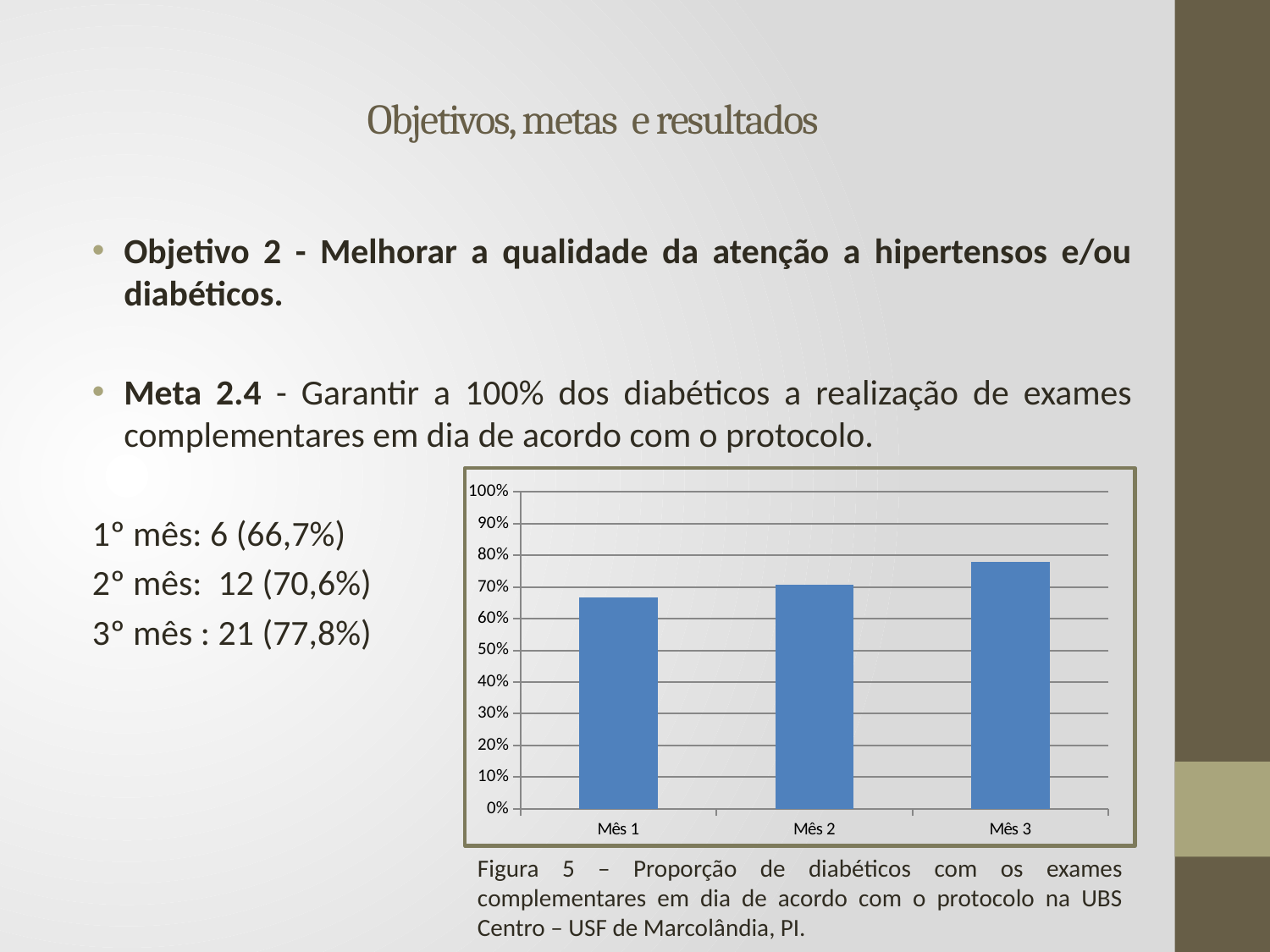
What is the figure number and caption subject of the chart? Figura 5 – Proporção de diabéticos com os exames complementares em dia de acordo com o protocolo na UBS Centro – USF de Marcolândia, PI. According to the slide text, what proportion corresponds to the 3º mês (Mês 3)? 77,8% Which is larger, the value for Mês 2 or the value for Mês 3? Mês 3 What kind of chart is shown on the slide? bar chart Do the values in the chart rise or fall from Mês 1 to Mês 3? rise Which month has the highest bar in the chart? Mês 3 Is the value for Mês 3 greater or less than 70%? greater Is the value for Mês 3 greater or less than 80%? less Is the value for Mês 1 greater or less than 60%? greater Which month has the lowest bar in the chart? Mês 1 How many categories (months) are shown on the x axis of the chart? 3